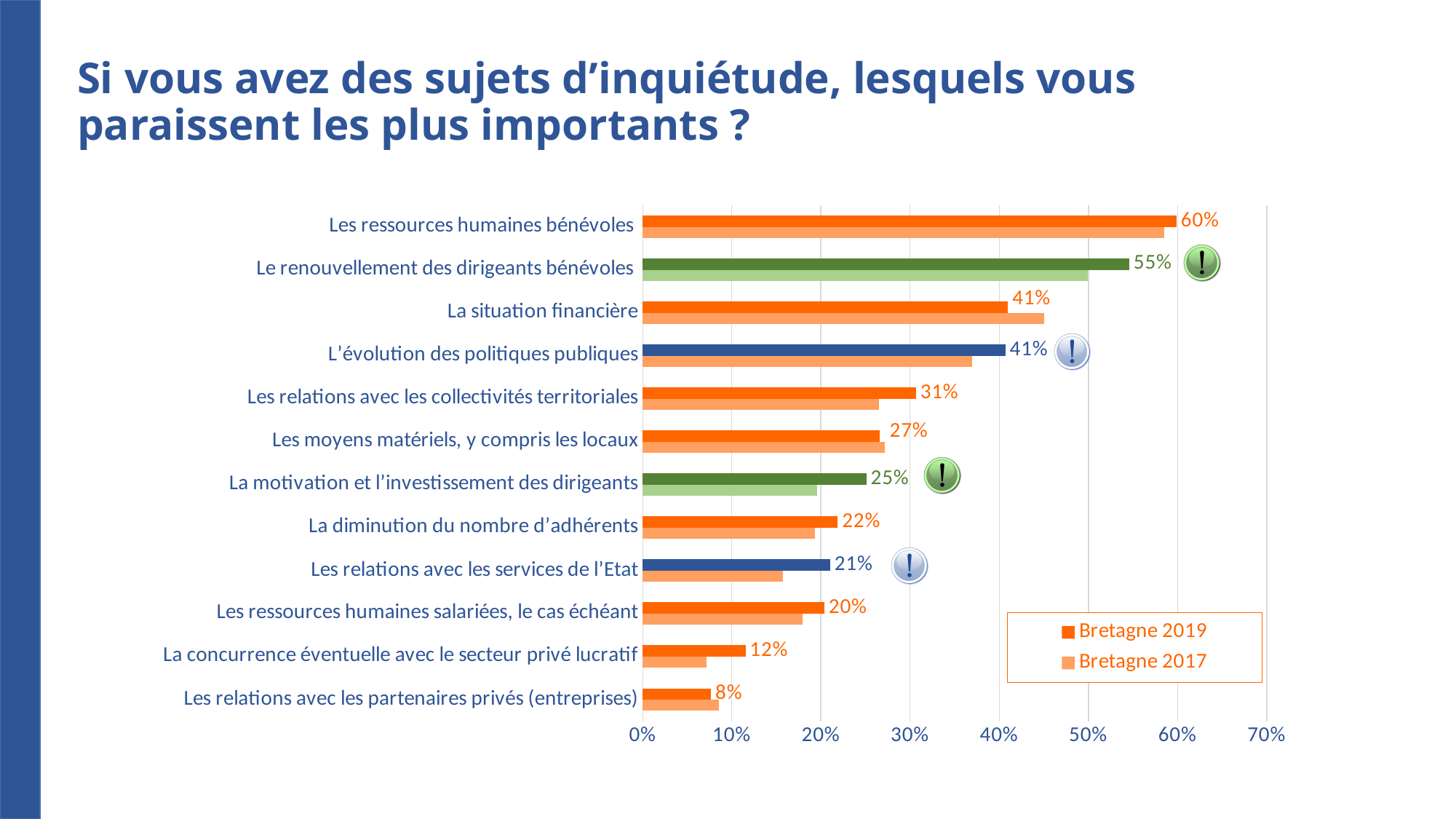
Which category has the highest Bretagne 2019 value? Les ressources humaines bénévoles What is the Bretagne 2019 value for 'La motivation et l'investissement des dirigeants'? 25% How many categories are plotted on the chart? 12 How many series does the legend list? 2 Which has the larger Bretagne 2019 value: 'Les relations avec les collectivités territoriales' or 'Les moyens matériels, y compris les locaux'? Les relations avec les collectivités territoriales Is the Bretagne 2017 value for 'La situation financière' greater or less than 40%? greater Which category has the lowest Bretagne 2019 value? Les relations avec les partenaires privés (entreprises) What is the difference between the Bretagne 2019 values for 'Les ressources humaines bénévoles' and 'Le renouvellement des dirigeants bénévoles'? 5% What type of chart is shown on the slide? bar chart What is the Bretagne 2019 value for 'Le renouvellement des dirigeants bénévoles'? 55% Is the Bretagne 2017 value for 'Les relations avec les services de l'Etat' greater or less than 20%? less What is the Bretagne 2019 value for 'Les ressources humaines bénévoles'? 60%